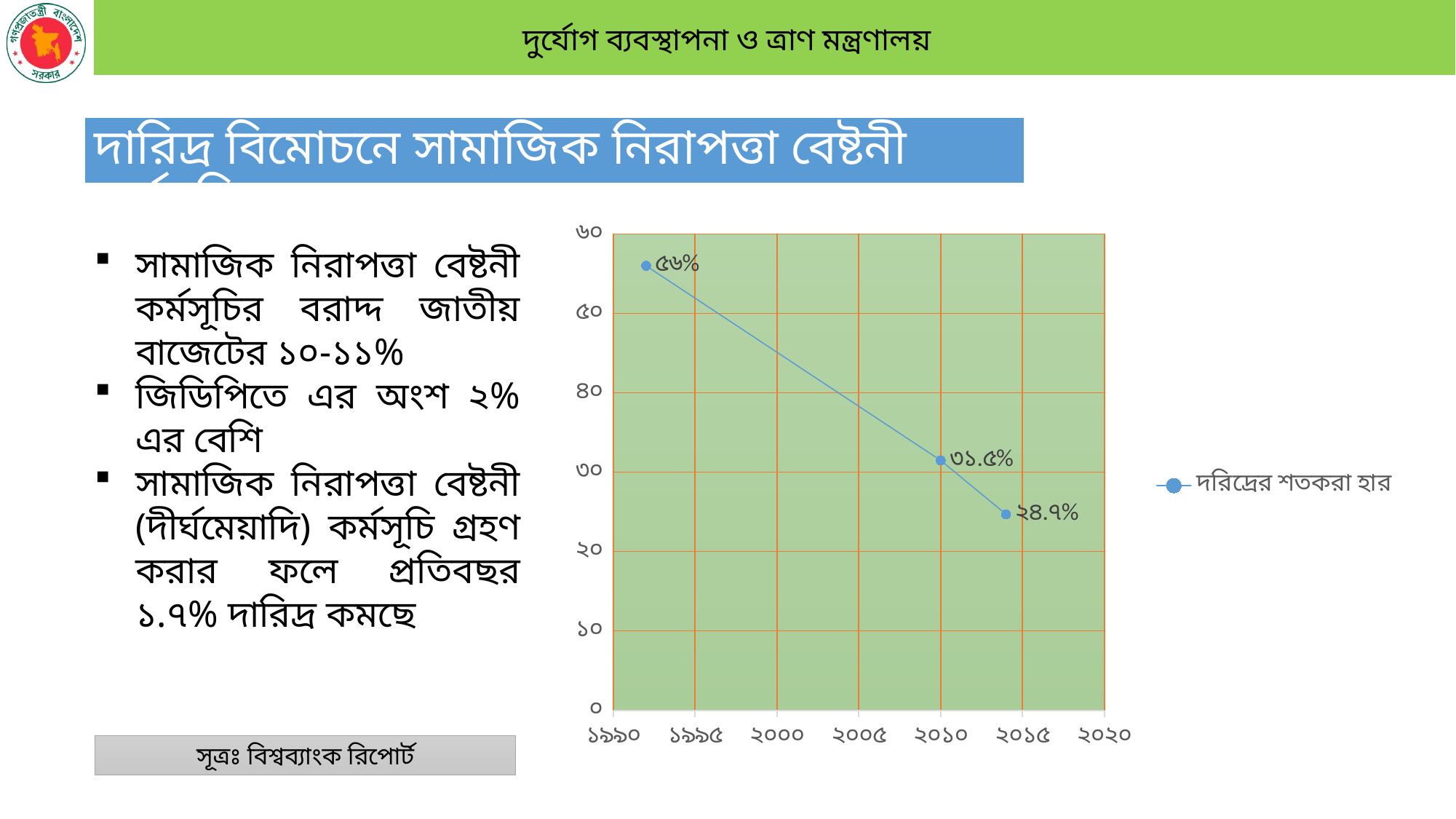
What is the difference between the first point (৫৬%) and the last point (২৪.৭%)? ৩১.৩% What is the data label on the first (leftmost) point of the line? ৫৬% What is the data label on the last (rightmost) point of the line? ২৪.৭% How many series does the legend list? 1 Which point has the lowest value? the last (rightmost) point, ২৪.৭% What is the legend entry for the plotted series? দরিদ্রের শতকরা হার What kind of chart is shown on the slide? line chart Is the value of the first point greater or less than ৫০? greater Which point has the highest value? the first (leftmost) point, ৫৬% What is the data label on the middle point of the line? ৩১.৫% How many data points are plotted on the line? 3 Do the values rise or fall from left to right along the x axis? fall